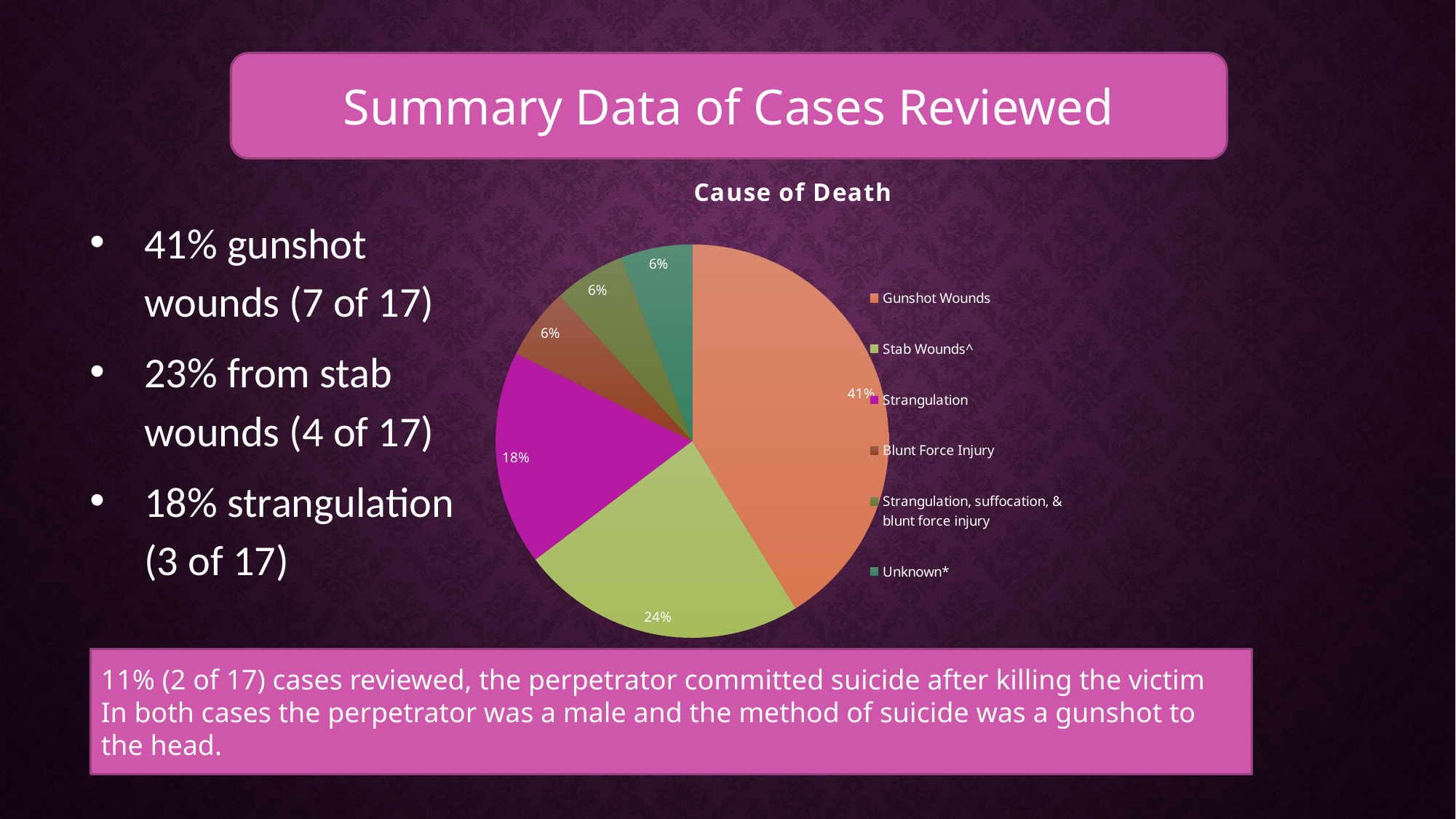
What is the difference in percentage points between the Gunshot Wounds slice and the Stab Wounds^ slice? 17 What is the difference in percentage points between the Strangulation slice and the Blunt Force Injury slice? 12 What percentage is shown for the Strangulation slice? 18% What kind of chart is shown on the slide? pie chart Which legend entry is shown in magenta? Strangulation What is the title of the chart? Cause of Death Which cause of death has the largest slice of the pie? Gunshot Wounds Which slice is larger, Strangulation or Stab Wounds^? Stab Wounds^ What share of the pie does Gunshot Wounds take? 41% What percentage is shown for the Stab Wounds^ slice? 24% How many categories does the legend of the pie chart list? 6 What percentage is shown for the Unknown* slice? 6%